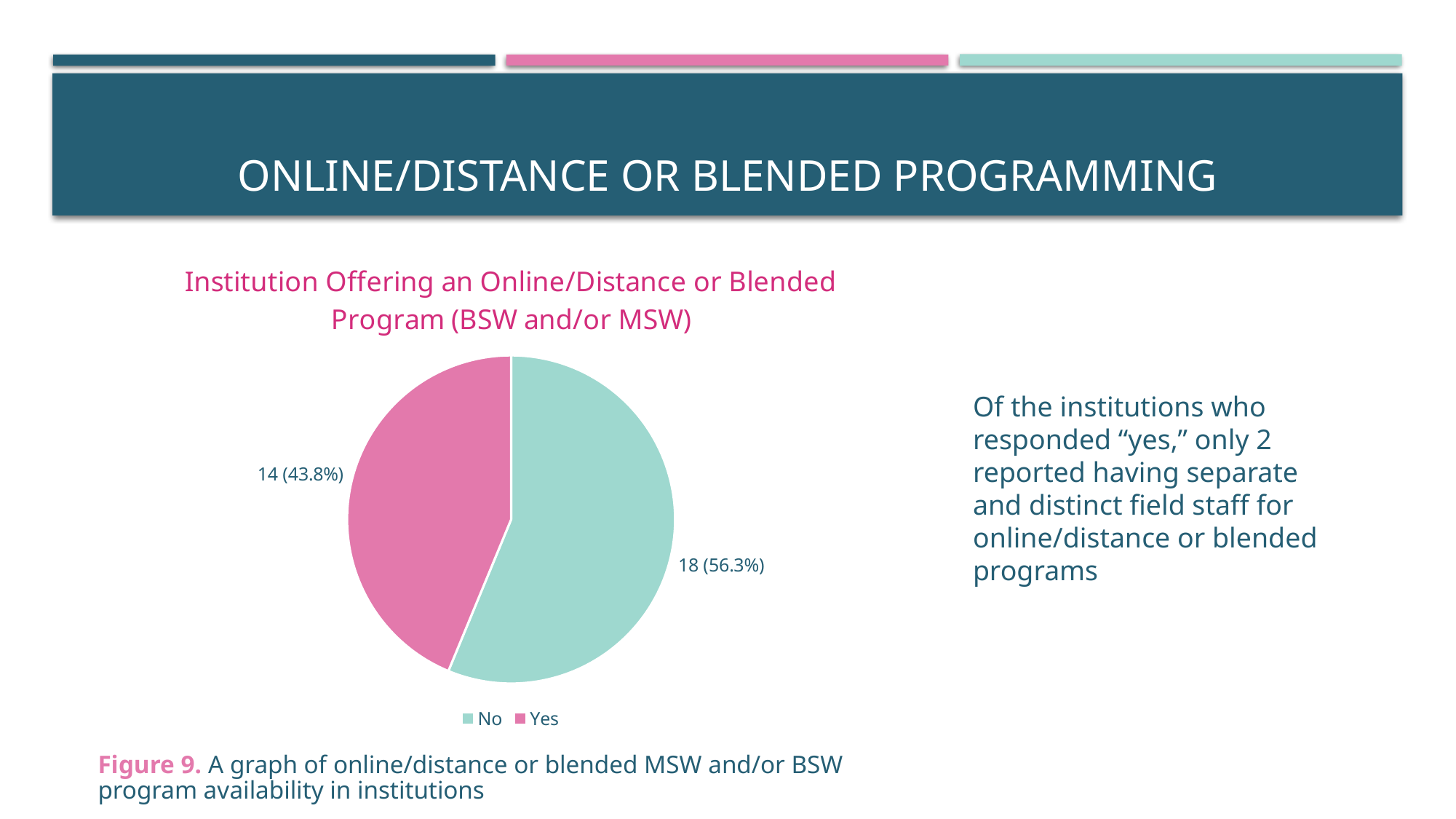
What kind of chart is shown on the slide? pie chart What is the title of the chart? Institution Offering an Online/Distance or Blended Program (BSW and/or MSW) How many institutions responded "Yes"? 14 How many institutions responded "No"? 18 Which category has the smallest slice? Yes Which colour represents the "Yes" slice? pink Which category has the larger slice, "No" or "Yes"? No What share of the pie does the "Yes" slice represent? 43.8% What is the total number of institutions represented in the pie chart? 32 What share of the pie does the "No" slice represent? 56.3% How many categories does the pie chart have? 2 What is the difference between the number of "No" and "Yes" responses? 4